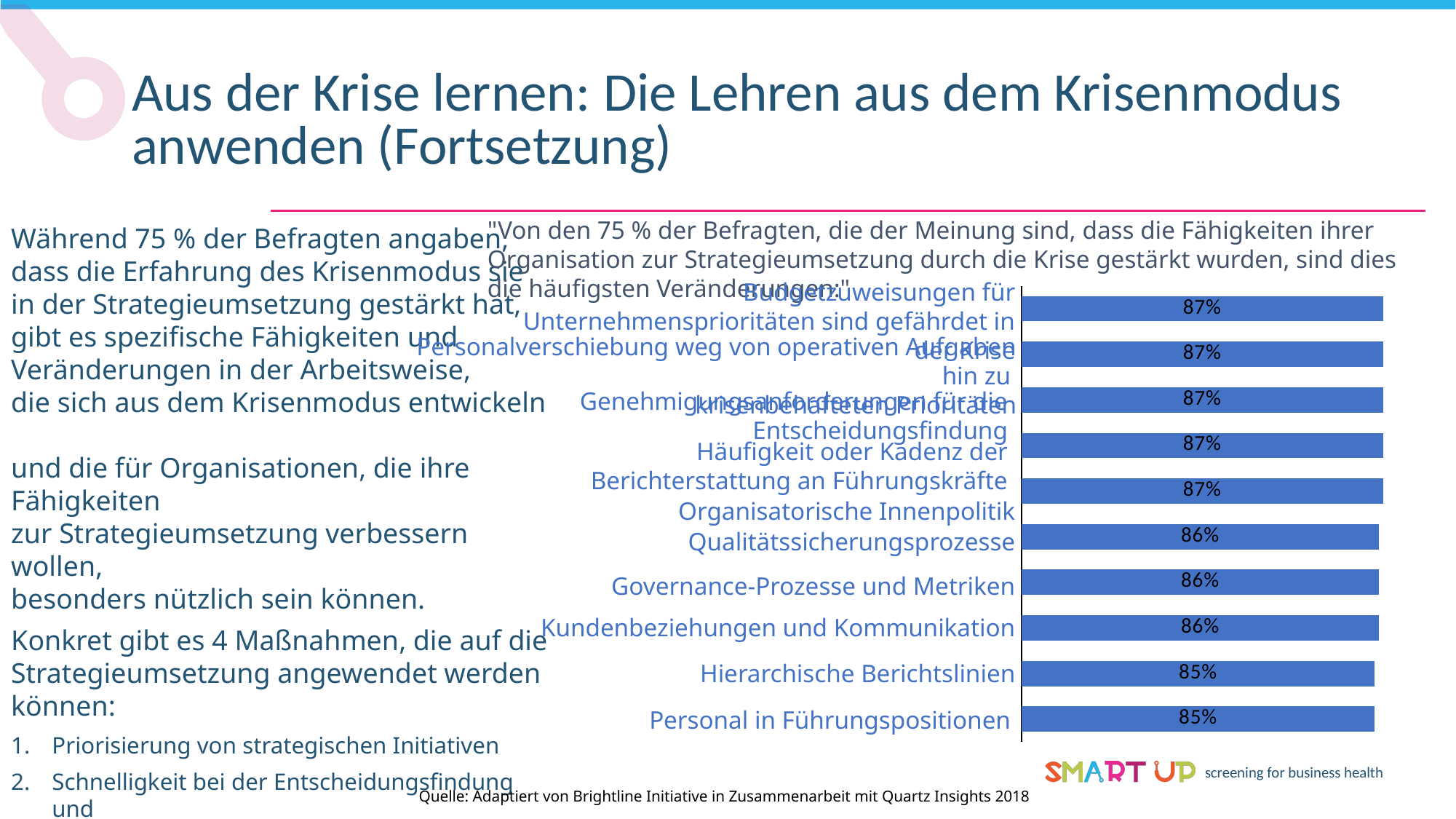
What colour are the bars in the chart? Blue How many bars does the chart show? 10 What value is shown for Governance-Prozesse und Metriken? 86% Which is larger, the value for Organisatorische Innenpolitik or the value for Personal in Führungspositionen? Organisatorische Innenpolitik What value is shown for Organisatorische Innenpolitik? 87% What kind of chart is shown on the slide? Bar chart What is the difference between the value for Organisatorische Innenpolitik and the value for Hierarchische Berichtslinien? 2 percentage points What value is shown for Hierarchische Berichtslinien? 85% What value is shown for Qualitätssicherungsprozesse? 86% What value is shown for Personal in Führungspositionen? 85% Do the values rise or fall going from the top bar to the bottom bar? Fall What value is shown for Kundenbeziehungen und Kommunikation? 86%